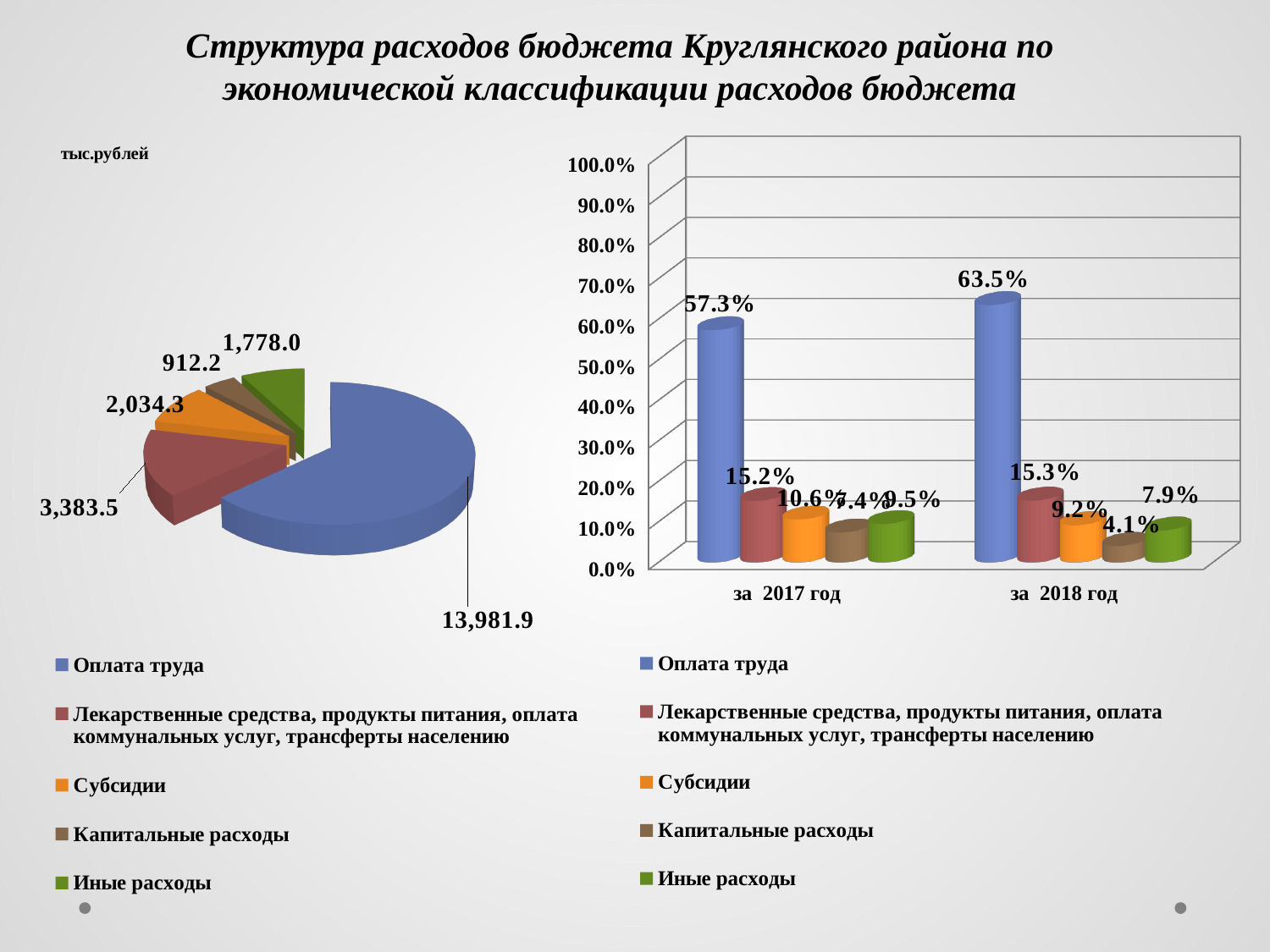
How many slices does the pie chart on the left have? 5 In the bar chart on the right, what is the value for Оплата труда за 2018 год? 63.5% In the bar chart on the right, is the value for Капитальные расходы larger in 2017 or in 2018? 2017 In the pie chart on the left, what is the value for Оплата труда? 13,981.9 What kind of chart is the chart on the left of the slide? Pie chart In the bar chart on the right, by how many percentage points did Оплата труда increase from 2017 to 2018? 6.2 In the pie chart on the left, which category has the smallest slice? Капитальные расходы In the pie chart on the left, which category has the largest slice? Оплата труда What kind of chart is the chart on the right of the slide? Bar chart How many series does the legend of the bar chart on the right list? 5 In the pie chart on the left, what is the difference between the values for Субсидии and Капитальные расходы? 1,122.1 In the bar chart on the right, what is the value for Субсидии за 2017 год? 10.6%